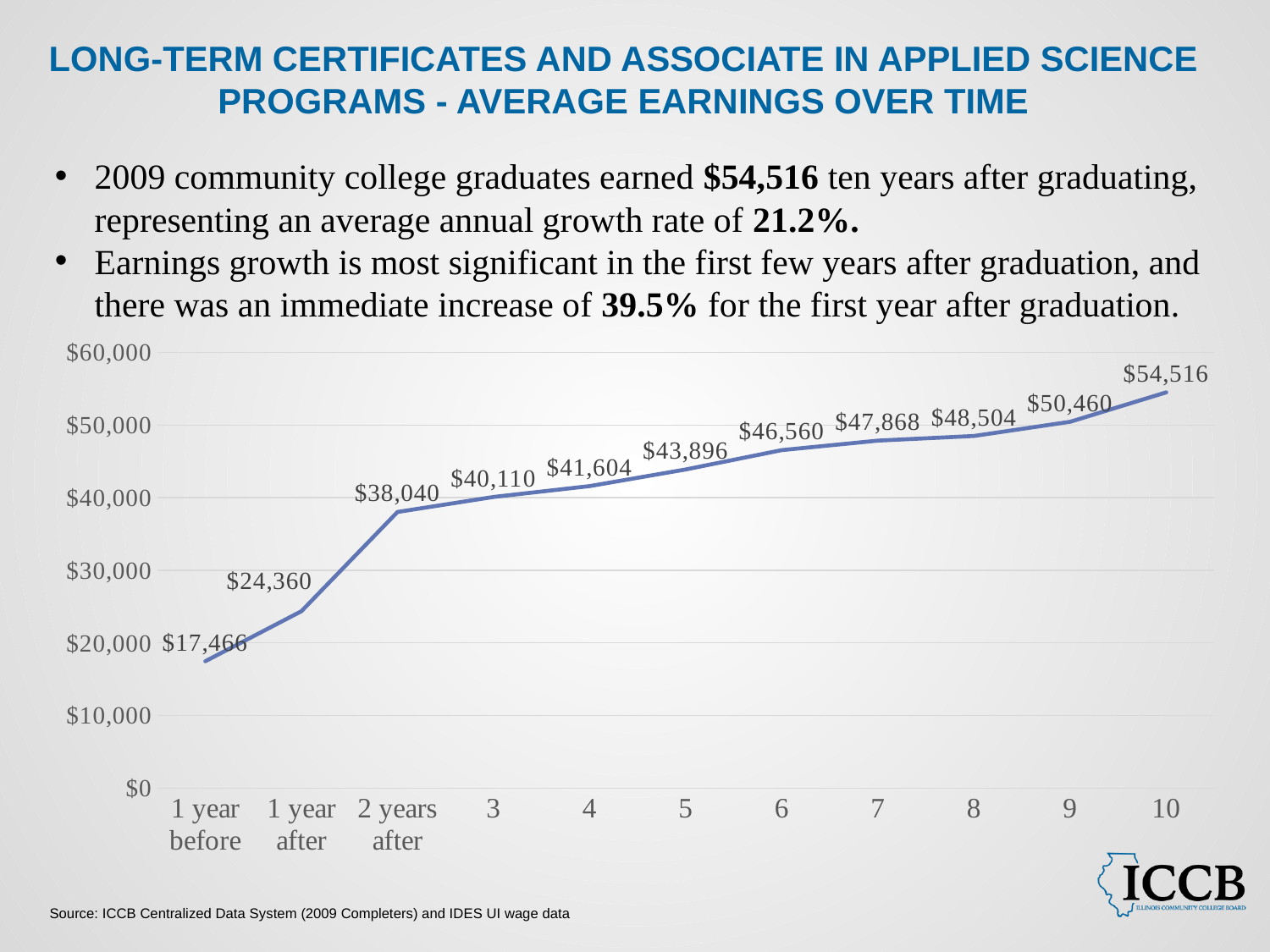
What were average earnings 2 years after graduation? $38,040 What were average earnings at year 7? $47,868 Is the value for year 8 greater or less than $50,000? less Do average earnings rise or fall along the x axis? Rise What type of chart is shown on the slide? Line chart What is the difference in average earnings between year 10 and year 9? $4,056 Which is larger, average earnings at year 5 or at year 6? Year 6 What is the difference in average earnings between 1 year after and 1 year before graduation? $6,894 Which point on the chart has the lowest average earnings? 1 year before Which point on the chart has the highest average earnings? 10 How many data points are plotted on the chart? 11 What were average earnings 1 year before graduation? $17,466